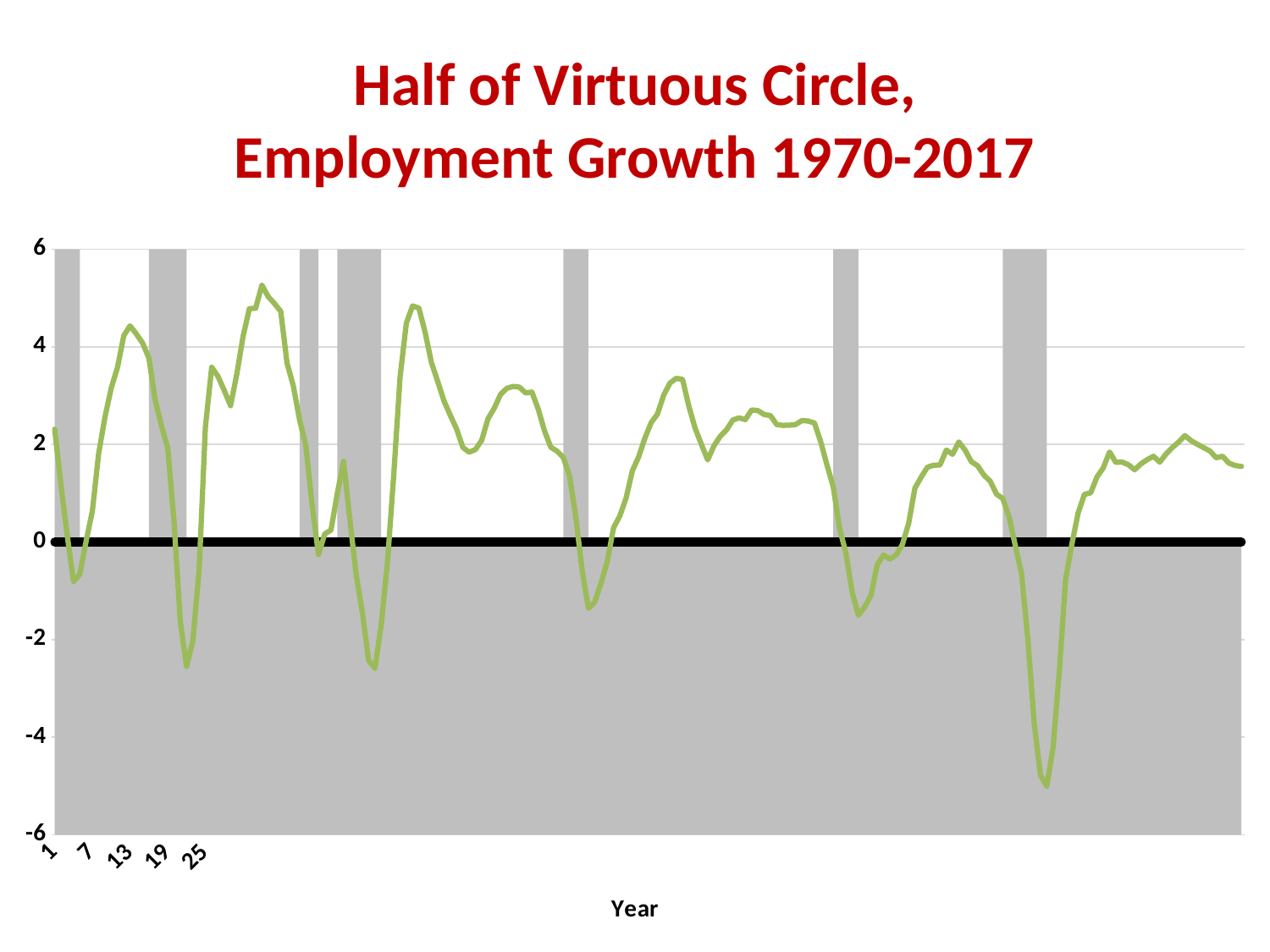
Is the highest point of the line greater or less than 4? greater What is the label on the x axis of the chart? Year What is the title of the chart? Half of Virtuous Circle, Employment Growth 1970-2017 Is the value at the right-hand end of the line greater or less than 0? greater Do the peaks of the line generally get higher or lower moving from left to right along the x axis? lower What is the highest value shown on the y axis? 6 Is the lowest point of the line greater or less than -4? less What kind of chart is shown on the slide? line chart Which is larger: the highest peak in the left half of the chart or the highest peak in the right half of the chart? the left half